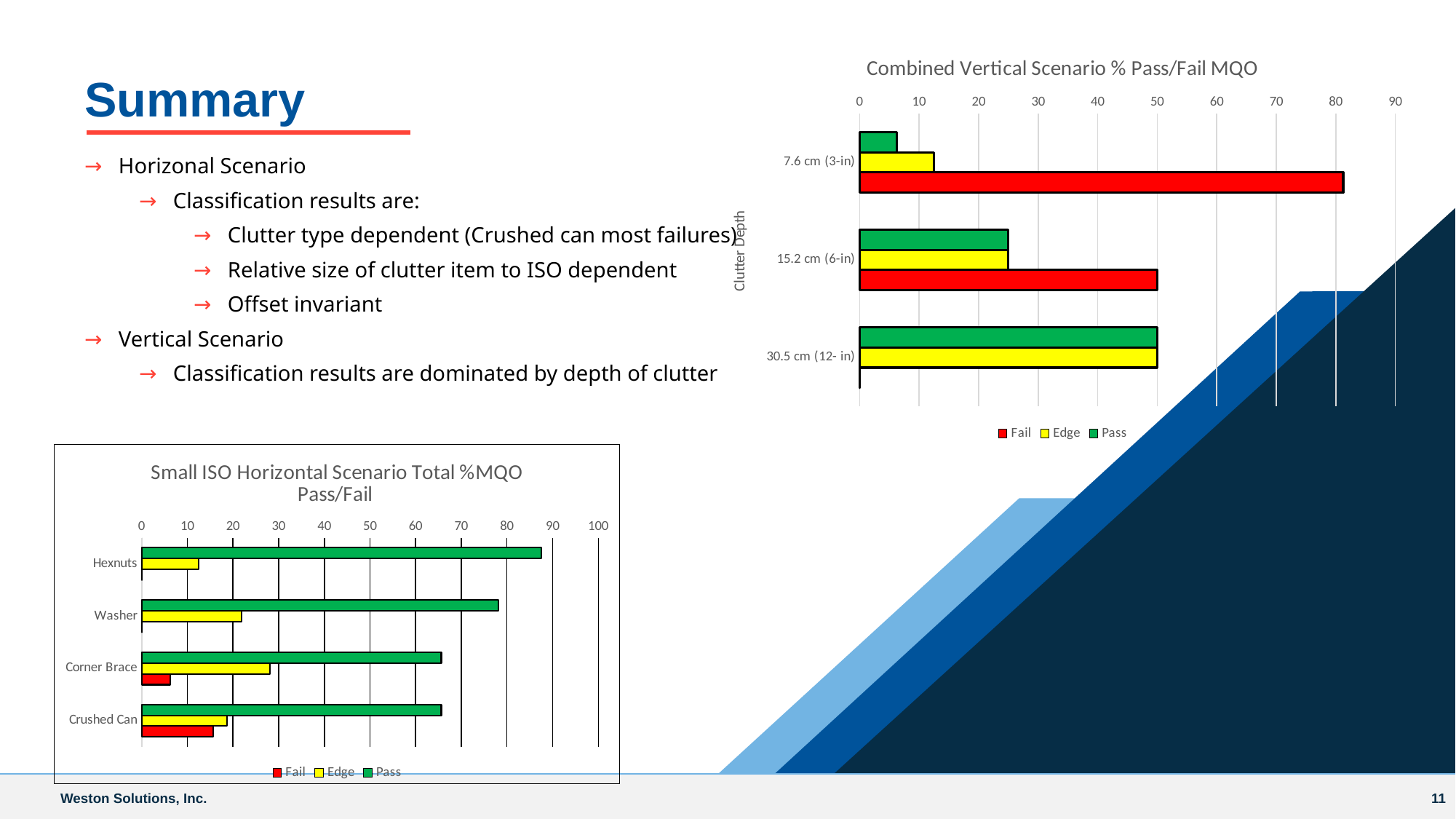
In the 'Small ISO Horizontal Scenario Total %MQO Pass/Fail' chart, is the Pass value for Washer greater or less than 70? greater What is the label of the vertical axis on the 'Combined Vertical Scenario % Pass/Fail MQO' chart? Clutter Depth In the 'Combined Vertical Scenario % Pass/Fail MQO' chart, does the Fail value rise or fall as clutter depth increases from 7.6 cm to 30.5 cm? fall In the 'Small ISO Horizontal Scenario Total %MQO Pass/Fail' chart, which is larger: the Edge value for Corner Brace or the Edge value for Hexnuts? Corner Brace How many clutter depth categories are shown in the 'Combined Vertical Scenario % Pass/Fail MQO' chart? 3 In the 'Combined Vertical Scenario % Pass/Fail MQO' chart, is the Fail value for 7.6 cm (3-in) greater or less than 80? greater In the 'Small ISO Horizontal Scenario Total %MQO Pass/Fail' chart, which clutter item has the highest Pass value? Hexnuts In the 'Combined Vertical Scenario % Pass/Fail MQO' chart, which clutter depth has the highest Fail value? 7.6 cm (3-in) In the 'Small ISO Horizontal Scenario Total %MQO Pass/Fail' chart, which clutter item has the highest Fail value? Crushed Can How many series does the legend of the 'Combined Vertical Scenario % Pass/Fail MQO' chart list? 3 What kind of chart is the 'Combined Vertical Scenario % Pass/Fail MQO' chart? bar chart In the 'Combined Vertical Scenario % Pass/Fail MQO' chart, what is the Fail value for 15.2 cm (6-in)? 50